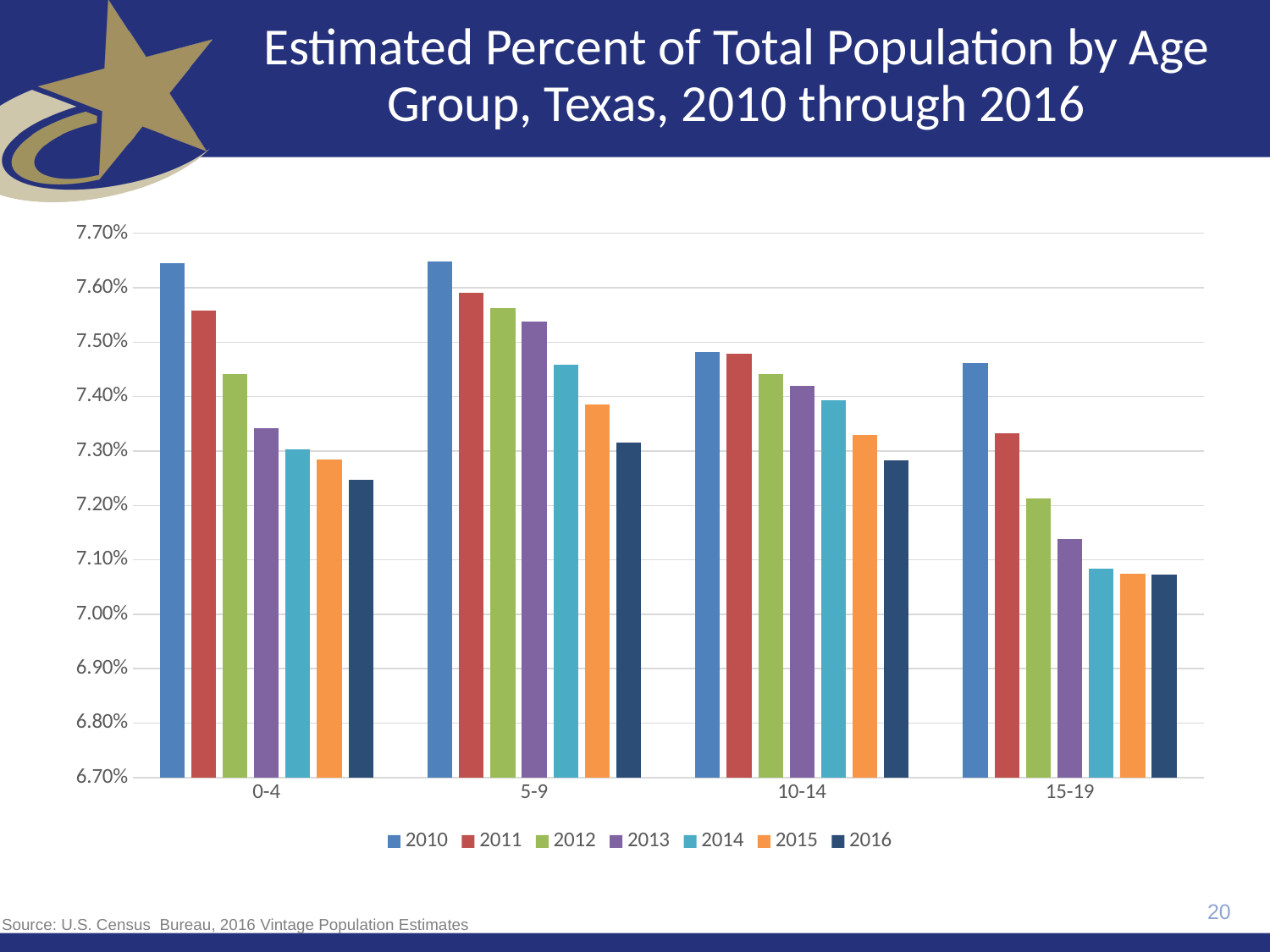
Is the value for 2011 in the 0-4 age group greater or less than 7.50%? greater What kind of chart is shown on the slide? bar chart Is the value for 2010 in the 5-9 age group greater or less than 7.60%? greater Is the value for 2014 in the 10-14 age group greater or less than 7.30%? greater What is the title of the chart? Estimated Percent of Total Population by Age Group, Texas, 2010 through 2016 How many series (years) does the legend list? 7 In the 15-19 age group, which is larger: the value for 2010 or the value for 2016? 2010 Which year has the highest value in the 15-19 age group? 2010 Within the 0-4 age group, do the values rise or fall from 2010 to 2016? fall How many age groups are shown on the x axis? 4